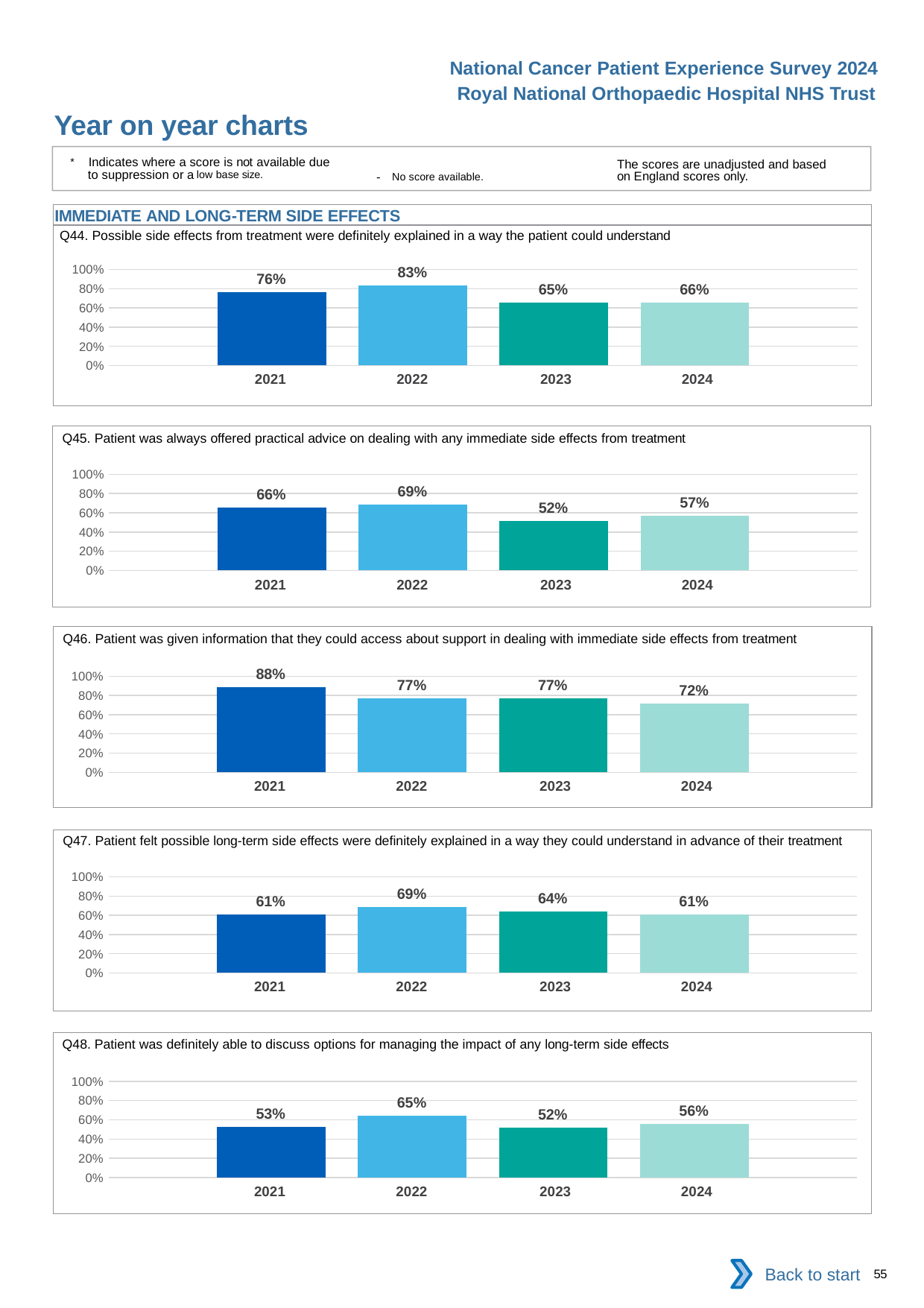
In the Q46 chart, which year has the highest value? 2021 In the Q48 chart, what is the difference between the 2022 and 2021 values? 12% How many bars are in the Q44 chart? 4 What type of chart is used for Q45? Bar chart In the Q47 chart, what is the value for 2021? 61% In the Q45 chart, what is the difference between the 2022 and 2023 values? 17% In the Q44 chart, which year has the lowest value? 2023 In the Q46 chart, what is the value for 2024? 72% In the Q47 chart, which is larger, the value for 2022 or the value for 2023? 2022 In the Q45 chart, what is the value for 2024? 57% In the Q48 chart, which year has the lowest value? 2023 In the Q44 chart, what is the value for 2022? 83%